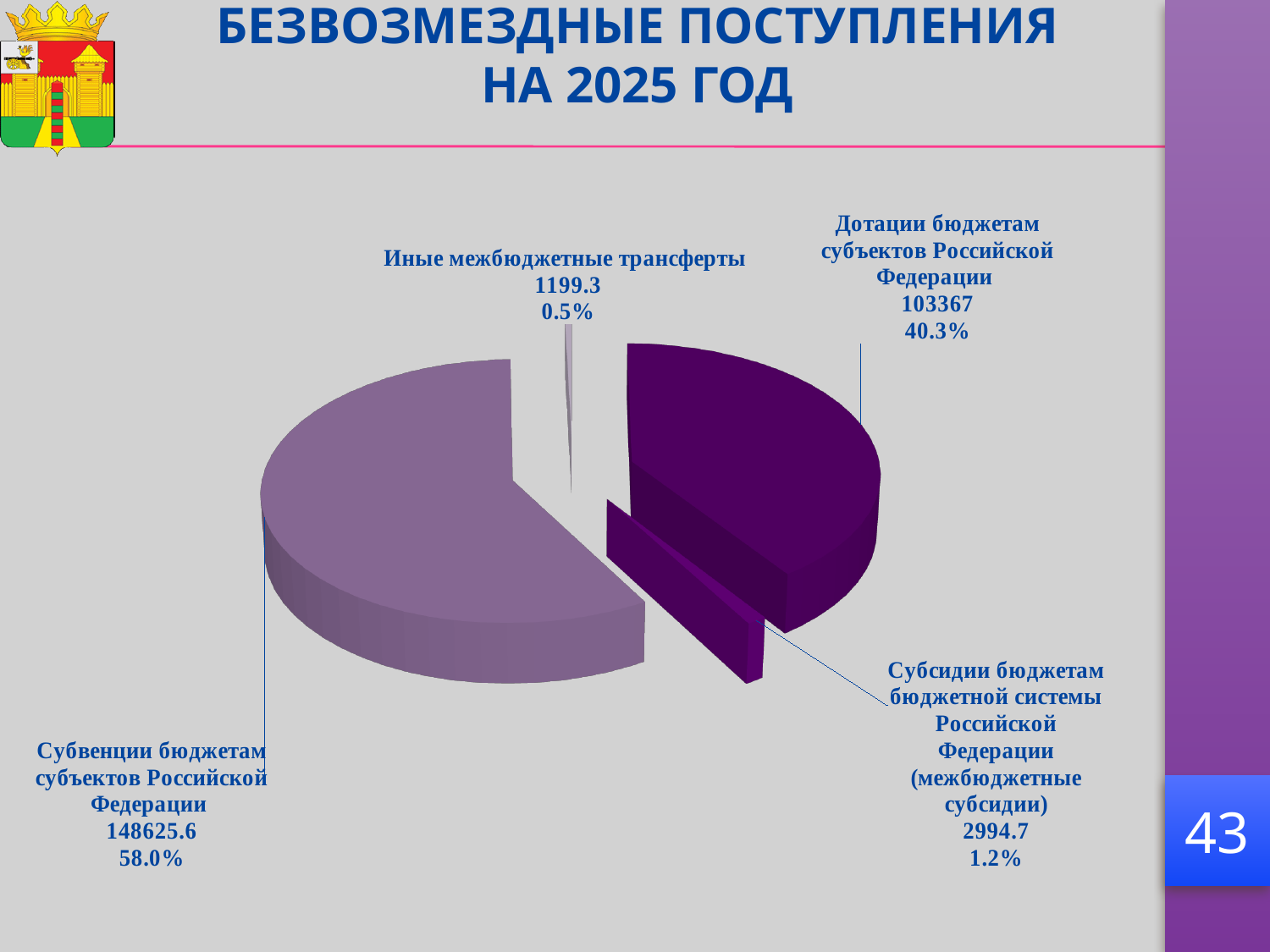
What share of the pie does Дотации бюджетам субъектов Российской Федерации represent? 40.3% What type of chart is shown on the slide? pie chart What is the value for Дотации бюджетам субъектов Российской Федерации? 103367 What is the value for Субсидии бюджетам бюджетной системы Российской Федерации (межбюджетные субсидии)? 2994.7 Which category has the smallest slice of the pie? Иные межбюджетные трансферты What share of the pie does Субвенции бюджетам субъектов Российской Федерации represent? 58.0% What is the value for Иные межбюджетные трансферты? 1199.3 Which category has the largest slice of the pie? Субвенции бюджетам субъектов Российской Федерации How many slices does the pie chart have? 4 What is the difference between the values for Субвенции бюджетам субъектов Российской Федерации and Дотации бюджетам субъектов Российской Федерации? 45258.6 Which is larger: the value for Субсидии (межбюджетные субсидии) or the value for Иные межбюджетные трансферты? Субсидии (межбюджетные субсидии) What is the value for Субвенции бюджетам субъектов Российской Федерации? 148625.6